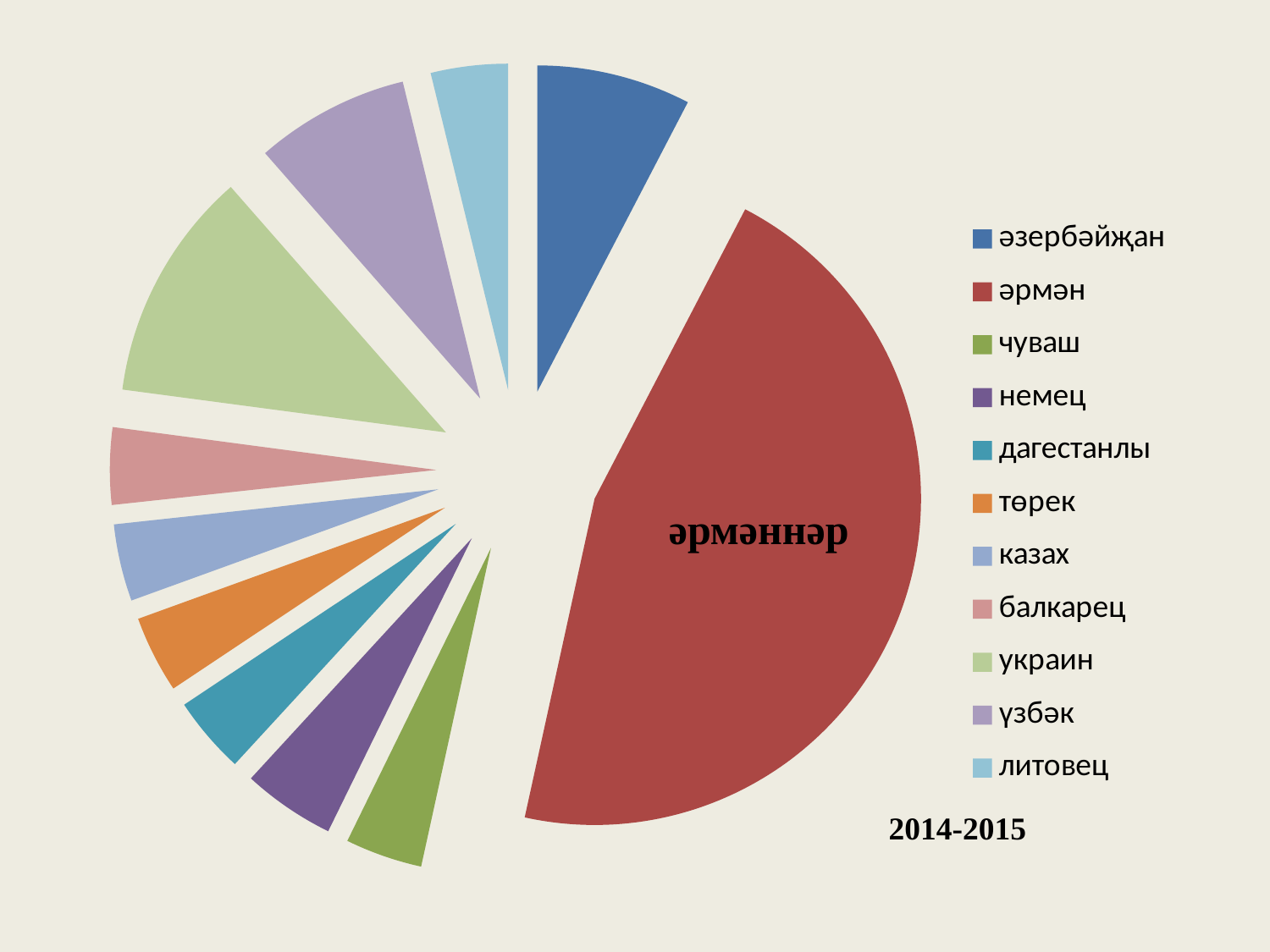
Which category has the largest slice in the pie chart? әрмән Which slice is larger, әрмән or украин? әрмән Which slice is larger, әзербәйҗан or чуваш? әзербәйҗан How many categories does the legend of the pie chart list? 11 Which slice is larger, украин or литовец? украин What period is written below the legend of the pie chart? 2014-2015 How many slices does the pie chart have? 11 What kind of chart is shown on the slide? pie chart What text label is printed on the largest slice of the pie chart? әрмәннәр